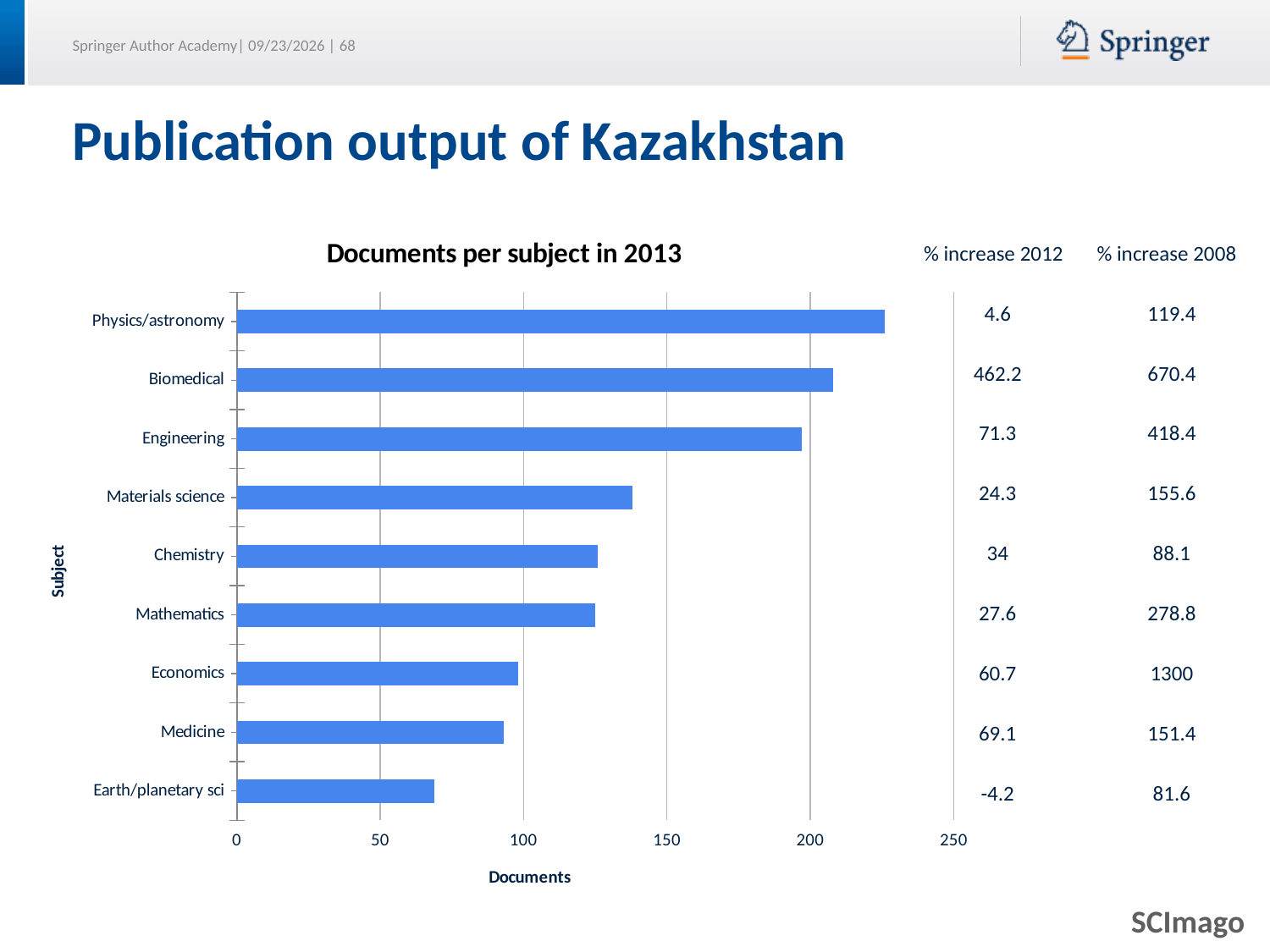
Is the value for Physics/astronomy greater or less than 200? greater What kind of chart is shown on the slide? bar chart Which subject has the highest number of documents? Physics/astronomy What is the label on the horizontal axis of the chart? Documents What is the title of the chart? Documents per subject in 2013 Is the value for Materials science greater or less than 100? greater Which has more documents, Physics/astronomy or Biomedical? Physics/astronomy Which subject has the lowest number of documents? Earth/planetary sci Is the value for Earth/planetary sci greater or less than 50? greater How many subjects are plotted in the chart? 9 Which has more documents, Materials science or Chemistry? Materials science